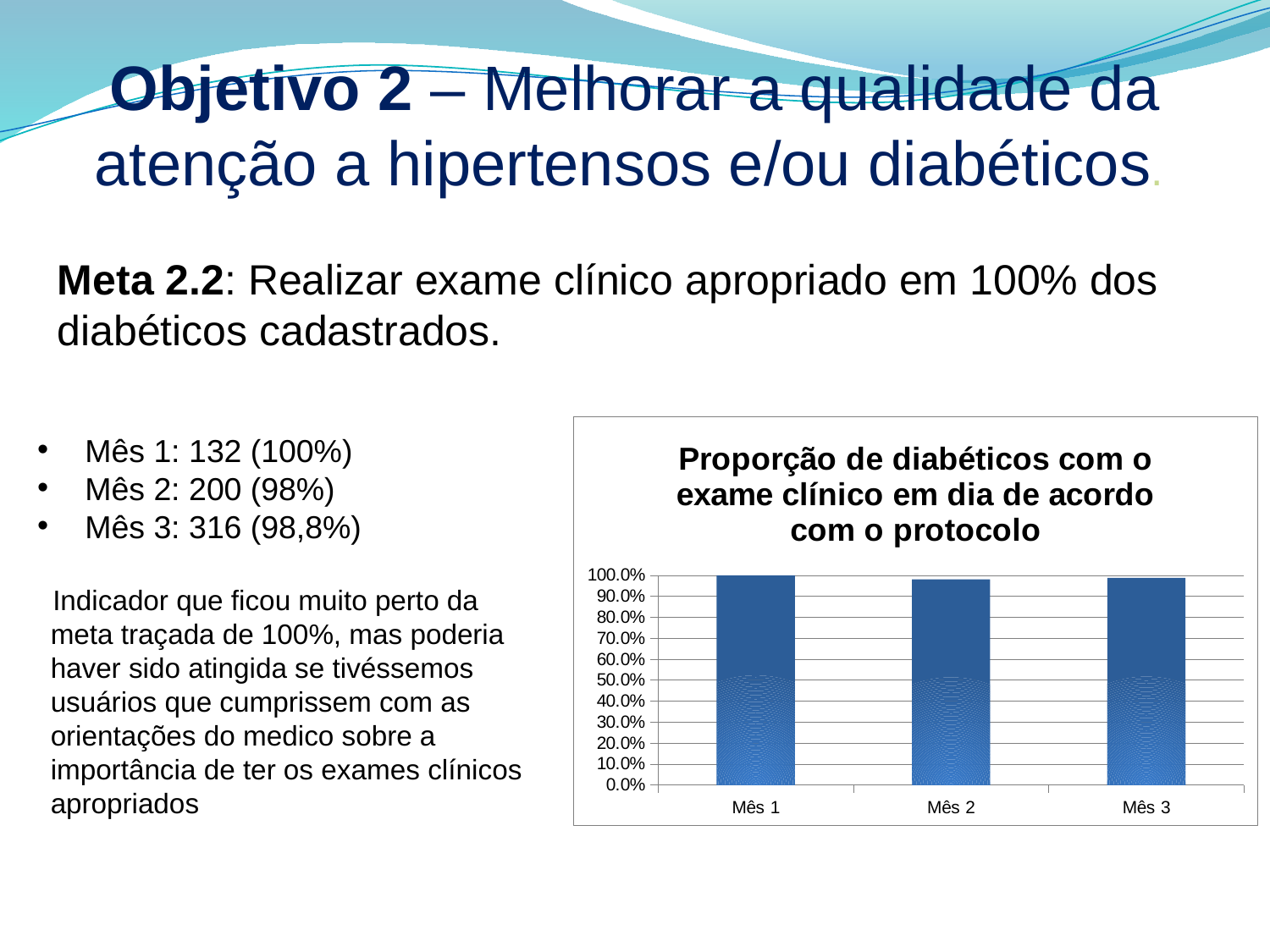
What is the lowest tick value shown on the y axis of the chart? 0.0% What is the highest tick value shown on the y axis of the chart? 100.0% What kind of chart is shown on the slide? bar chart How many categories (months) are shown on the x axis of the chart? 3 What is the title of the chart? Proporção de diabéticos com o exame clínico em dia de acordo com o protocolo Is the value for Mês 3 greater or less than 80.0%? greater Is the value for Mês 2 greater or less than 90.0%? greater What is the label of the first category on the x axis? Mês 1 What value does the bar for Mês 1 reach on the y axis? 100.0% Is the value for Mês 1 greater or less than 50.0%? greater